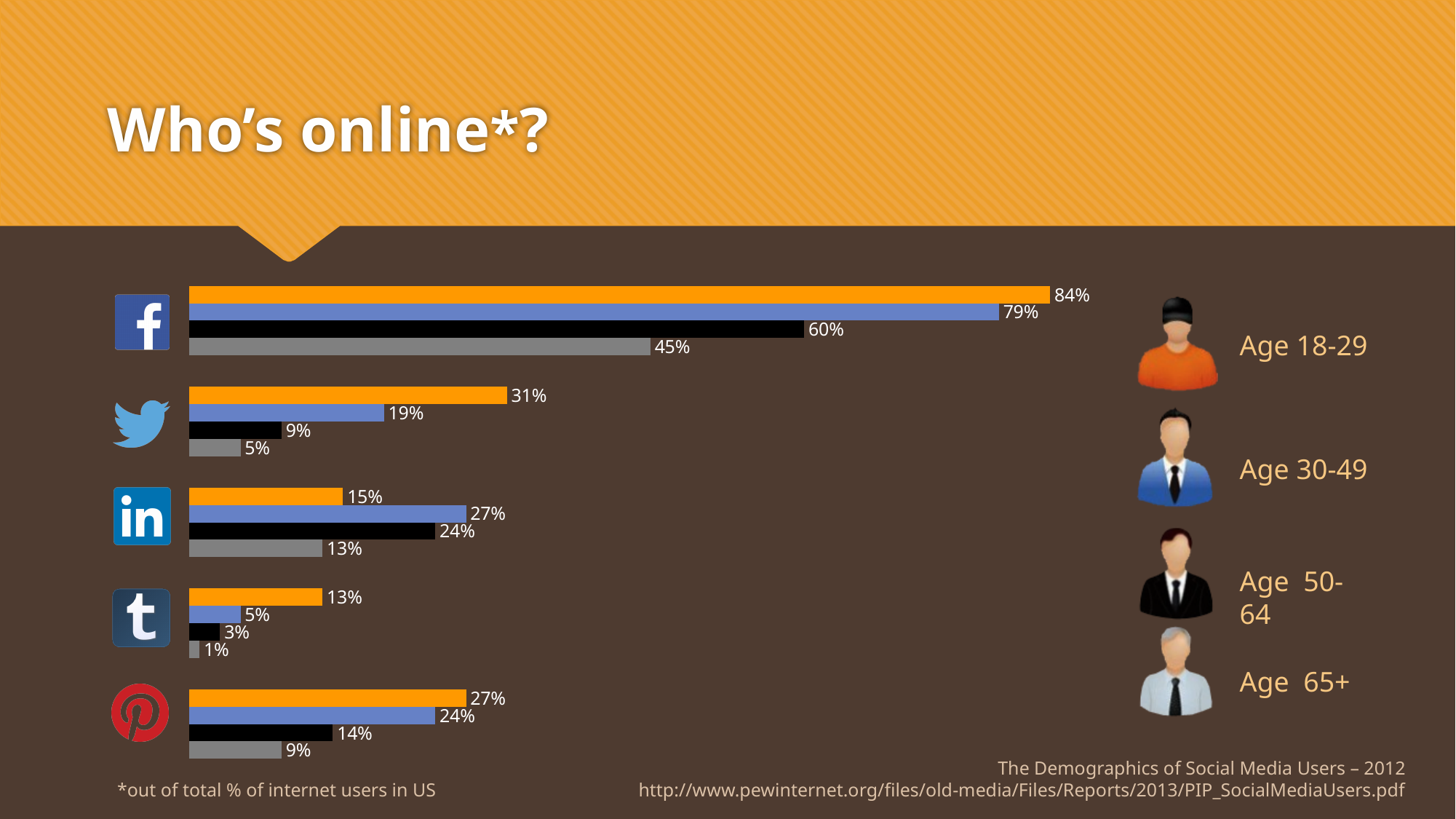
What kind of chart is shown on the slide? Bar chart What is the value for the Age 50-64 group on Pinterest? 14% Which age group has the highest value for LinkedIn? Age 30-49 What percentage of internet users aged 18-29 use Facebook? 84% What is the difference between the Age 18-29 and Age 65+ values for Facebook? 39% How many social media platforms are shown in the chart? 5 What percentage of the Age 30-49 group uses LinkedIn? 27% How many age groups does the legend list? 4 Which colour represents the Age 18-29 group in the chart? Orange What is the value for the Age 65+ group on Twitter? 5% Which is larger for Twitter: the Age 18-29 value or the Age 30-49 value? Age 18-29 Which age group has the lowest value for Tumblr? Age 65+